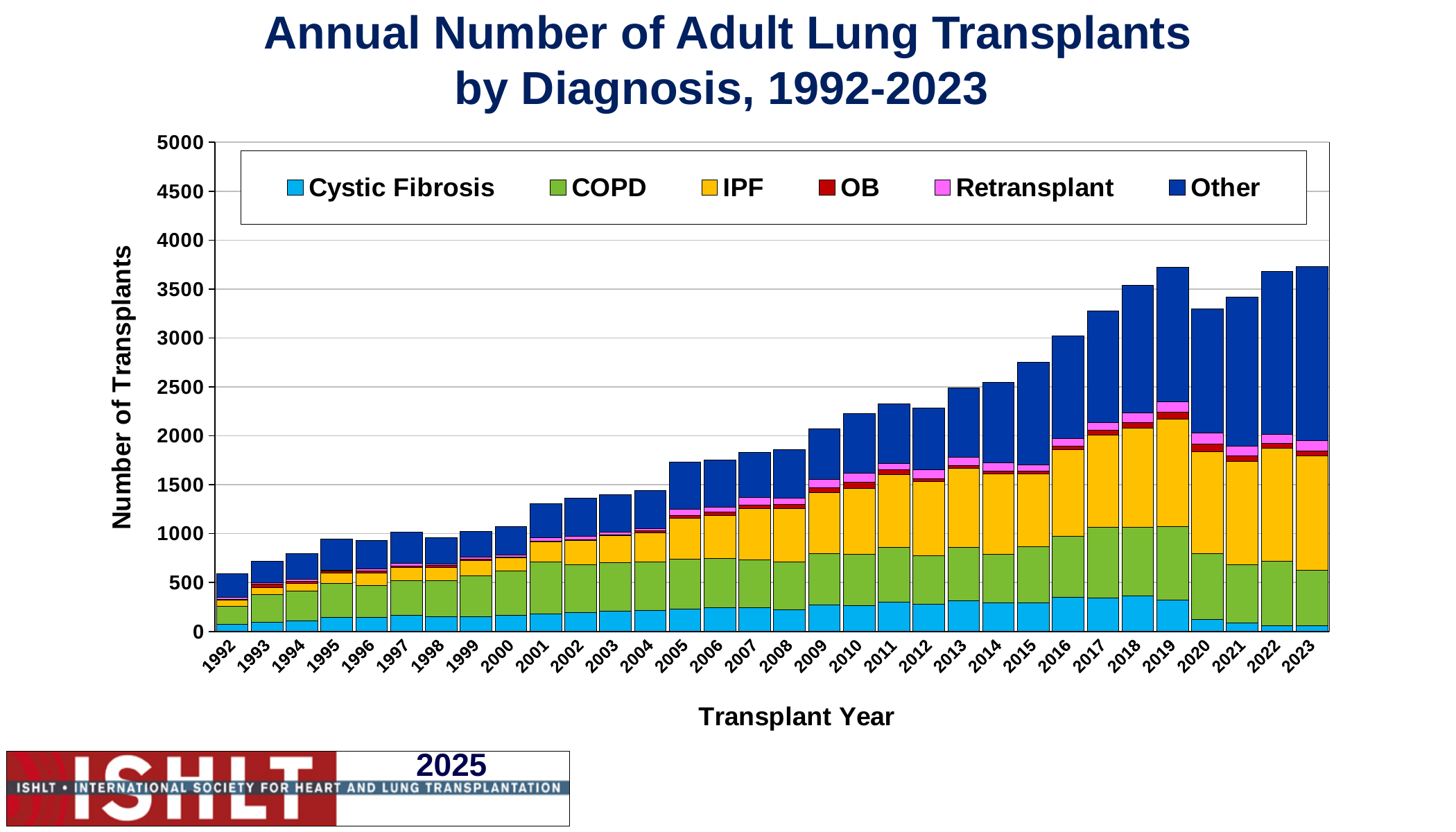
Is the total number of transplants in 2015 greater or less than 3000? less Is the total number of transplants in 1992 greater or less than 1000? less Which year has the larger total number of transplants, 2000 or 2001? 2001 Do the total annual transplant numbers generally rise or fall from 1992 to 2023? rise How many series does the legend list? 6 What is the label of the y axis? Number of Transplants Which year has the larger total number of transplants, 2019 or 2020? 2019 What type of chart is shown on the slide? Stacked bar chart Is the total number of transplants in 2023 greater or less than 3500? greater Which year has the lowest total number of transplants? 1992 How many transplant years are shown on the x axis? 32